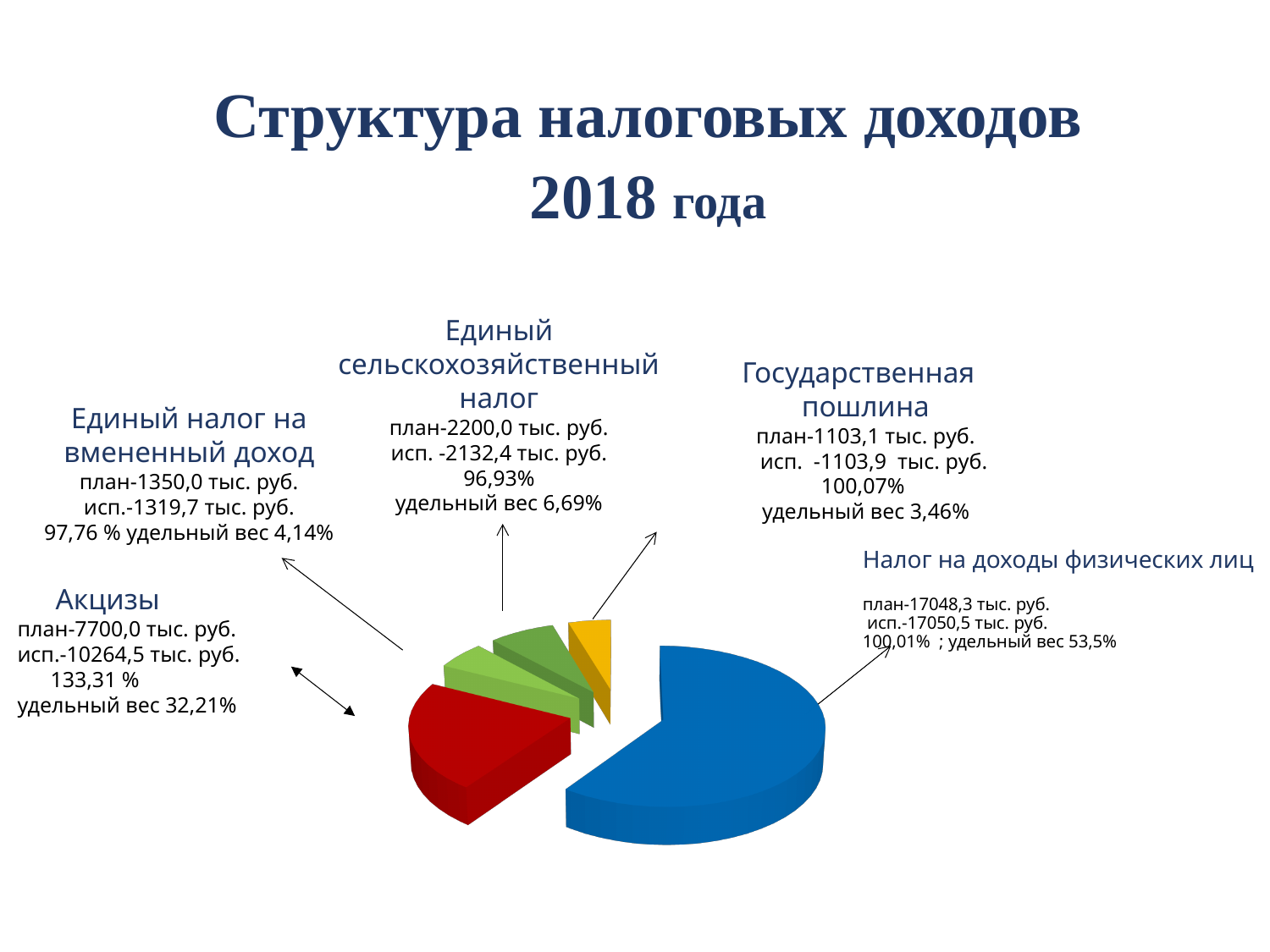
What is the share (удельный вес) of Акцизы? 32,21% What is the planned amount (план) for Акцизы? 7700,0 тыс. руб. What is the share (удельный вес) of Налог на доходы физических лиц? 53,5% Which tax category has the smallest share (удельный вес) of tax revenues in 2018? Государственная пошлина Which has a larger share: Единый налог на вмененный доход or Государственная пошлина? Единый налог на вмененный доход What is the difference in share between Налог на доходы физических лиц (53,5%) and Акцизы (32,21%)? 21,29% Which tax category has the largest share (удельный вес) of tax revenues in 2018? Налог на доходы физических лиц What kind of chart is shown on the slide? pie chart What is the executed amount (исп.) for Государственная пошлина? 1103,9 тыс. руб. What is the share (удельный вес) of Единый сельскохозяйственный налог? 6,69% How many slices does the pie chart have? 5 What colour is the slice representing Акцизы? red